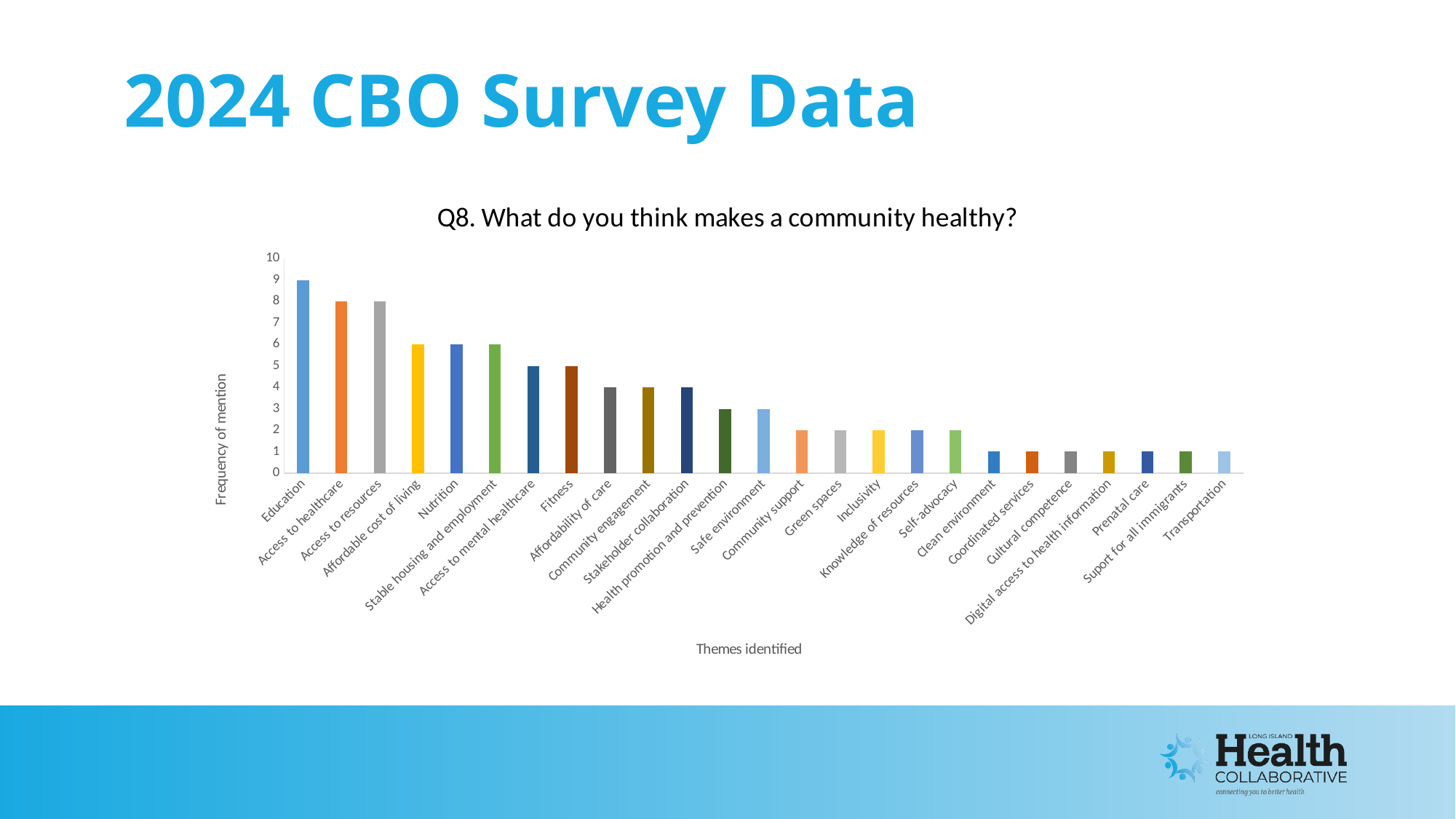
What is the frequency of mention for Fitness? 5 Which has a higher frequency of mention, Affordability of care or Health promotion and prevention? Affordability of care What is the frequency of mention for Education? 9 What is the label of the y axis? Frequency of mention What is the title of the chart? Q8. What do you think makes a community healthy? Is the value for Access to resources greater or less than 5? greater What is the frequency of mention for Safe environment? 3 What is the difference in frequency of mention between Education and Nutrition? 3 What is the frequency of mention for Access to healthcare? 8 What kind of chart is shown on the slide? Bar chart Which theme has the highest frequency of mention? Education How many themes are shown on the x axis of the chart? 25